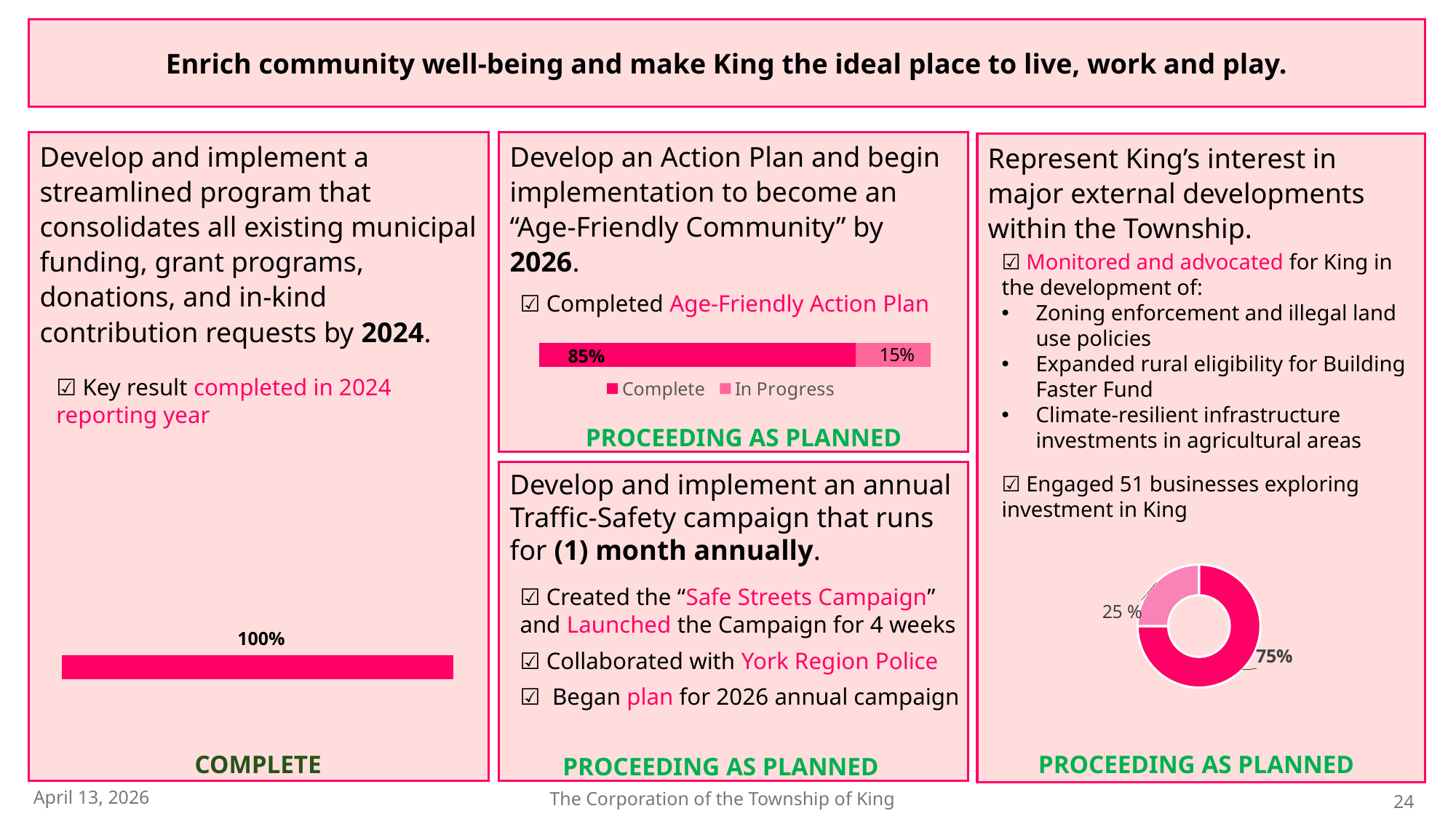
In the stacked bar chart in the middle panel (Age-Friendly Community), what is the value of the In Progress segment? 15% What value is labelled on the bar in the left panel (streamlined funding program)? 100% In the stacked bar chart in the middle panel (Age-Friendly Community), how many series does the legend list? 2 In the stacked bar chart in the middle panel (Age-Friendly Community), what is the total of the two segments? 100% In the donut chart in the right panel, what is the value of the larger slice? 75% What kind of chart is shown in the right panel (Represent King's interest)? Donut chart In the stacked bar chart in the middle panel (Age-Friendly Community), what are the two legend entries? Complete, In Progress In the stacked bar chart in the middle panel (Age-Friendly Community), what is the difference between the Complete and In Progress values? 70% In the stacked bar chart in the middle panel (Age-Friendly Community), what is the value of the Complete segment? 85% What kind of chart is shown in the middle panel under the Age-Friendly Action Plan text? Stacked bar chart In the stacked bar chart in the middle panel (Age-Friendly Community), which segment is larger, Complete or In Progress? Complete In the donut chart in the right panel, what is the value of the smaller slice? 25%